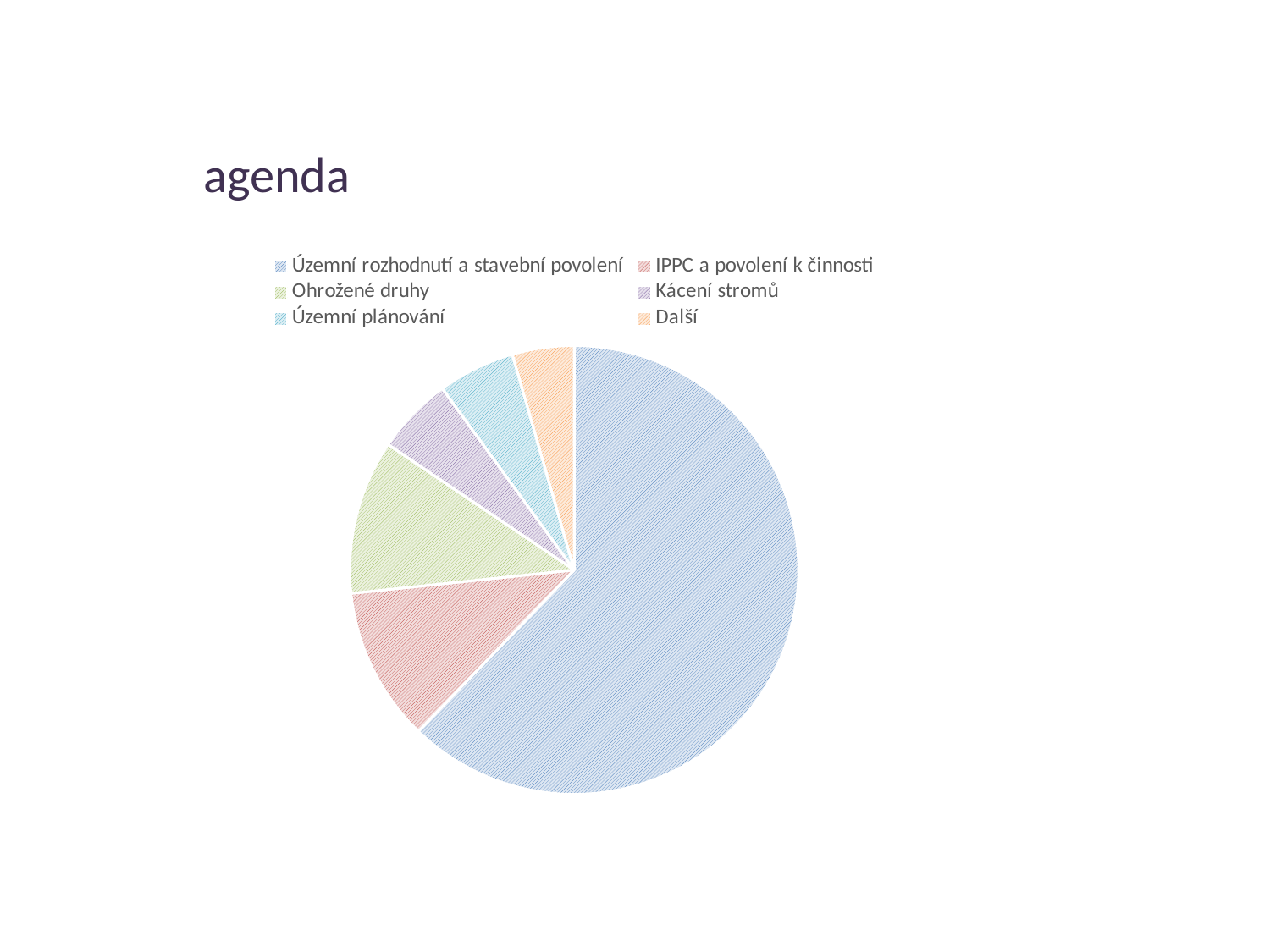
Which category has the largest slice of the pie chart? Územní rozhodnutí a stavební povolení What kind of chart is shown on the slide? pie chart How many slices does the pie chart have? 6 Which slice is larger: IPPC a povolení k činnosti or Další? IPPC a povolení k činnosti Does the slice for Územní rozhodnutí a stavební povolení account for more or less than half of the pie? more What is the title of the slide containing the pie chart? agenda Which colour represents Ohrožené druhy in the pie chart? green Which slice is larger: Ohrožené druhy or Kácení stromů? Ohrožené druhy Which slice is larger: Územní rozhodnutí a stavební povolení or IPPC a povolení k činnosti? Územní rozhodnutí a stavební povolení How many entries does the legend of the pie chart list? 6